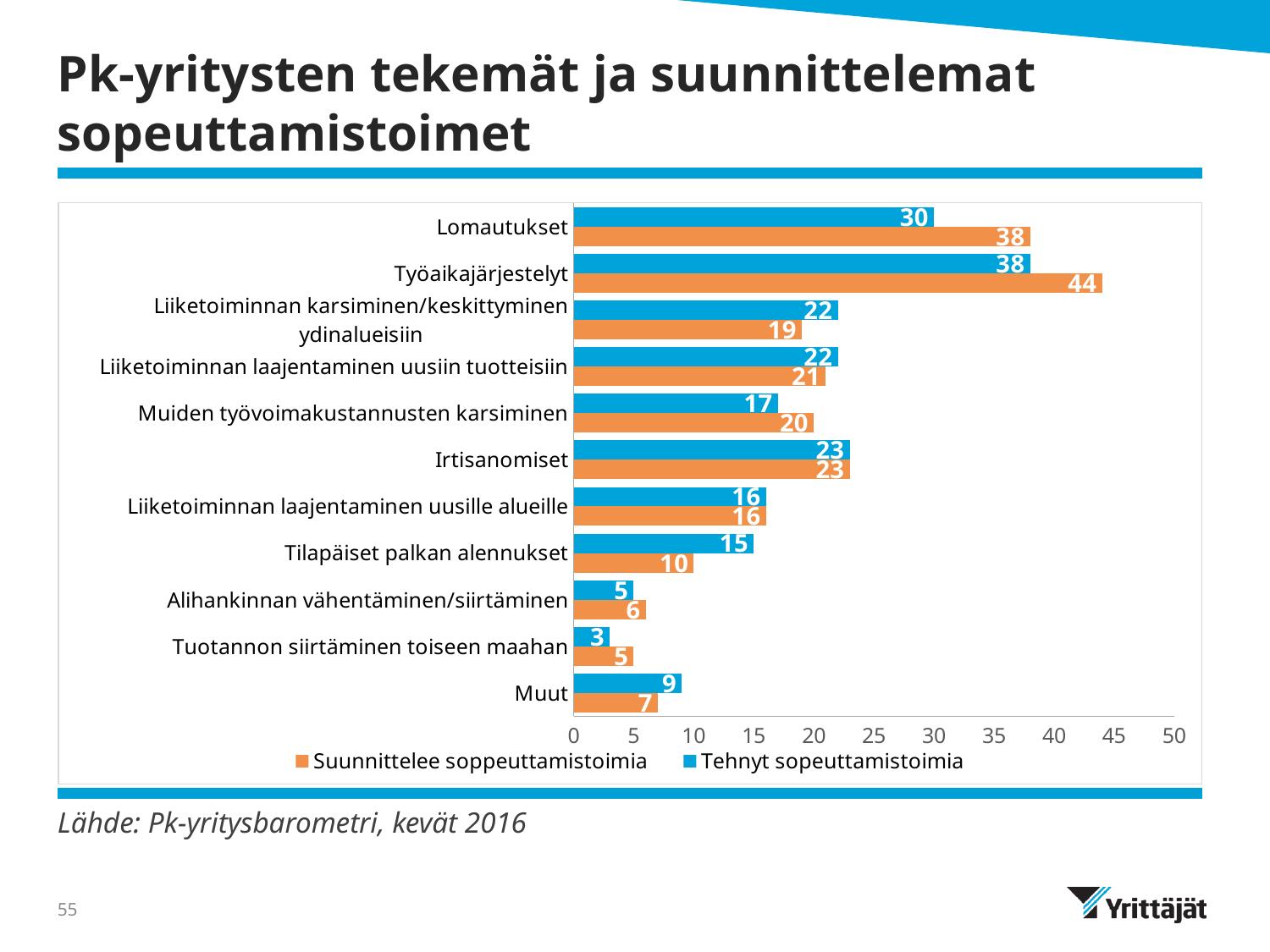
What kind of chart is shown on the slide? Bar chart Which category has the lowest value for 'Tehnyt sopeuttamistoimia'? Tuotannon siirtäminen toiseen maahan Is the 'Suunnittelee sopeuttamistoimia' value for Työaikajärjestelyt greater or less than 40? greater How many series does the legend list? 2 For Tilapäiset palkan alennukset, which series has the larger value: 'Tehnyt sopeuttamistoimia' or 'Suunnittelee sopeuttamistoimia'? Tehnyt sopeuttamistoimia What is the value of 'Tehnyt sopeuttamistoimia' for Lomautukset? 30 Which colour represents 'Tehnyt sopeuttamistoimia' in the chart? Blue How many categories are shown on the chart? 11 What is the difference between the 'Suunnittelee sopeuttamistoimia' and 'Tehnyt sopeuttamistoimia' values for Lomautukset? 8 What is the value of 'Suunnittelee sopeuttamistoimia' for Tilapäiset palkan alennukset? 10 What is the value of 'Suunnittelee sopeuttamistoimia' for Työaikajärjestelyt? 44 Which category has the highest value for 'Suunnittelee sopeuttamistoimia'? Työaikajärjestelyt